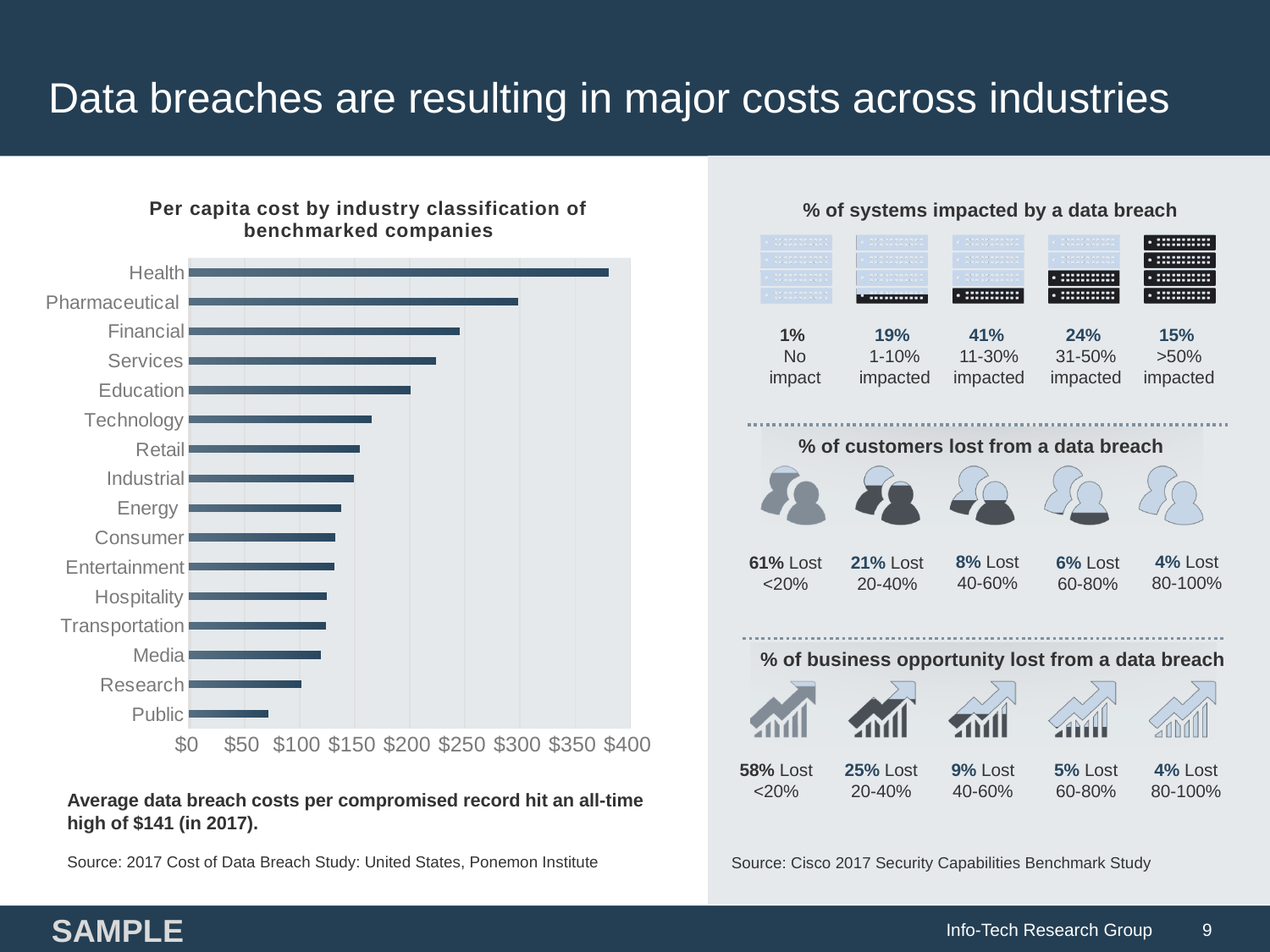
Is the per capita cost for Public greater or less than $100? less Is the per capita cost for Research greater or less than $150? less What is the title of the bar chart? Per capita cost by industry classification of benchmarked companies Is the per capita cost for Technology greater or less than $200? less Which has a higher per capita cost, Pharmaceutical or Services? Pharmaceutical What kind of chart is shown on the left side of the slide? bar chart How many industry categories are plotted in the bar chart? 16 Which industry has the lowest per capita cost in the bar chart? Public Do the bar lengths increase or decrease going from the top category (Health) to the bottom category (Public)? decrease Which industry has the highest per capita cost in the bar chart? Health